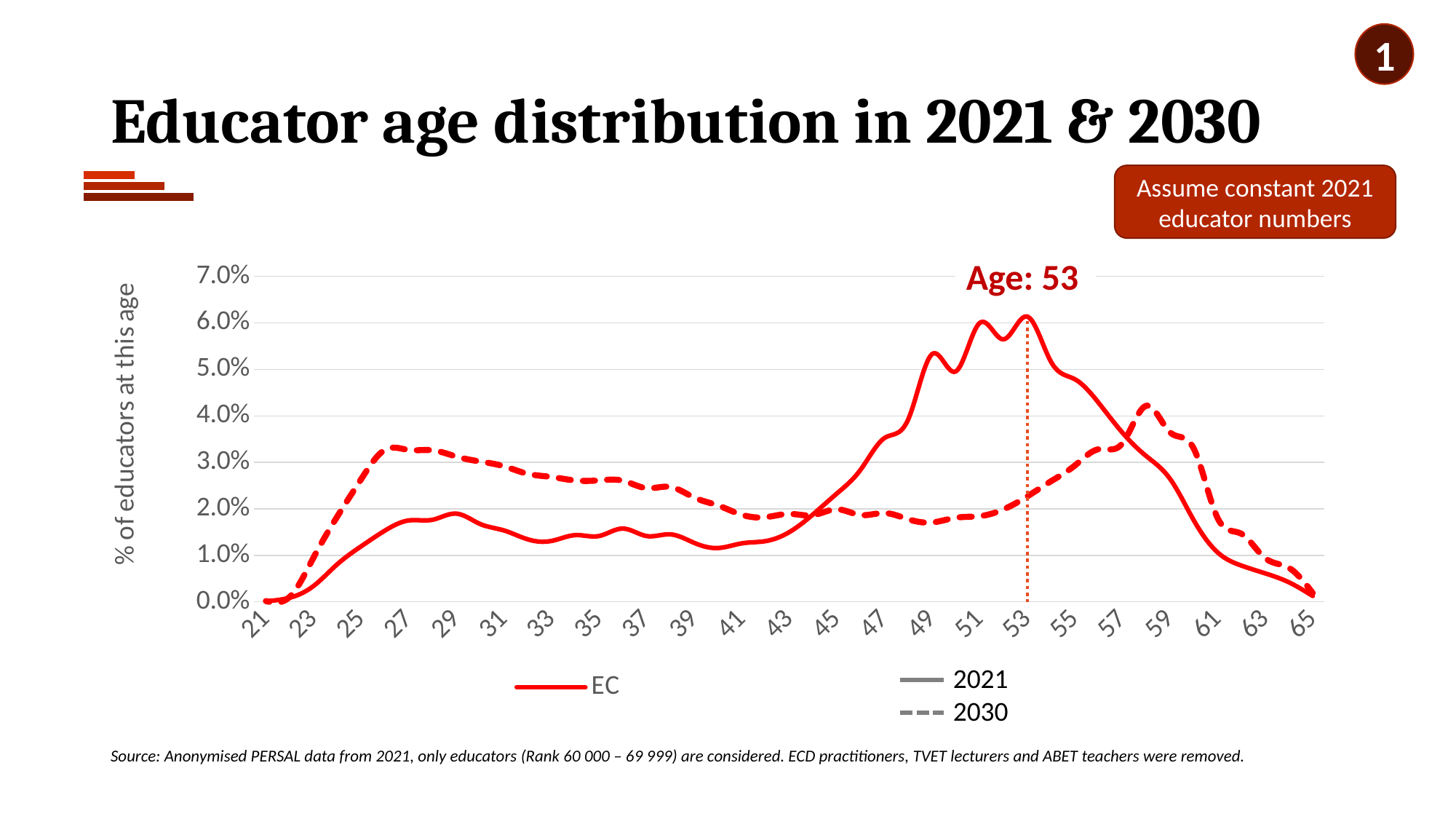
At age 27, which line is higher, 2021 or 2030? 2030 What type of chart is shown on the slide? line chart At what age does the 2021 line reach its peak, as annotated on the chart? 53 Between ages 53 and 65, does the 2021 line rise or fall? fall Which line has the higher overall peak, 2021 or 2030? 2021 According to the legend, what does the dashed line represent? 2030 What is the title of the chart on the slide? Educator age distribution in 2021 & 2030 At age 53, which line is higher, 2021 or 2030? 2021 Is the 2030 value at age 27 greater or less than 3.0%? greater At age 59, which line is higher, 2021 or 2030? 2030 Is the 2021 value at age 53 greater or less than 5.0%? greater Is the 2021 value at age 41 greater or less than 2.0%? less